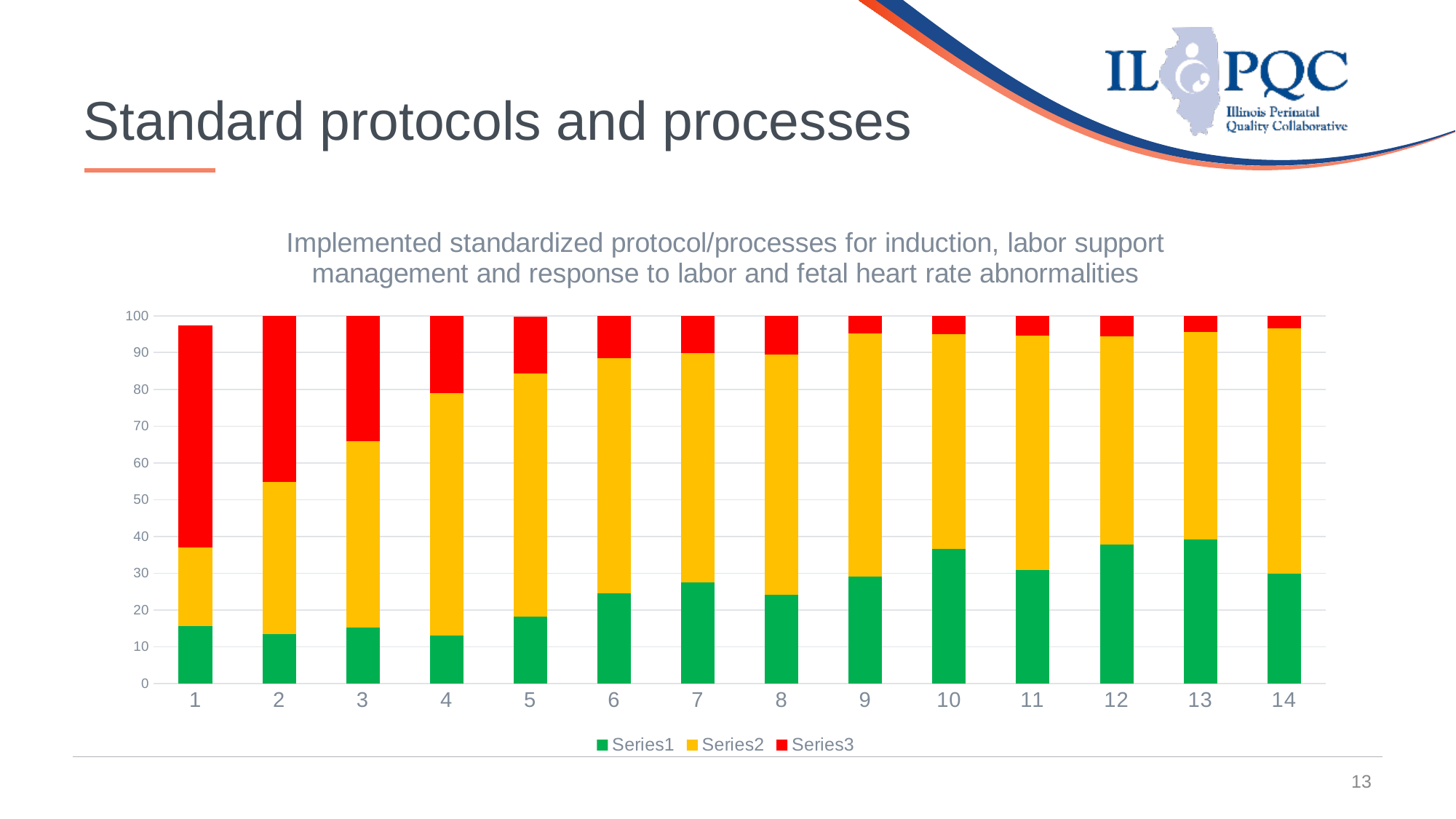
Which has the larger Series3 segment, category 1 or category 14? Category 1 How many categories are shown along the x axis of the chart? 14 Is the Series1 value for category 1 greater or less than 20? less Which has the larger Series1 value, category 2 or category 13? Category 13 What kind of chart is shown on the slide? Stacked bar chart What colour represents Series3 in the chart? Red Is the Series1 value for category 10 greater or less than 30? greater How many series does the chart's legend list? 3 Does the Series3 (red) segment generally rise or fall from category 1 to category 14? Fall Is the Series3 segment for category 14 greater or less than 10? less Which category has the largest Series3 (red) segment? 1